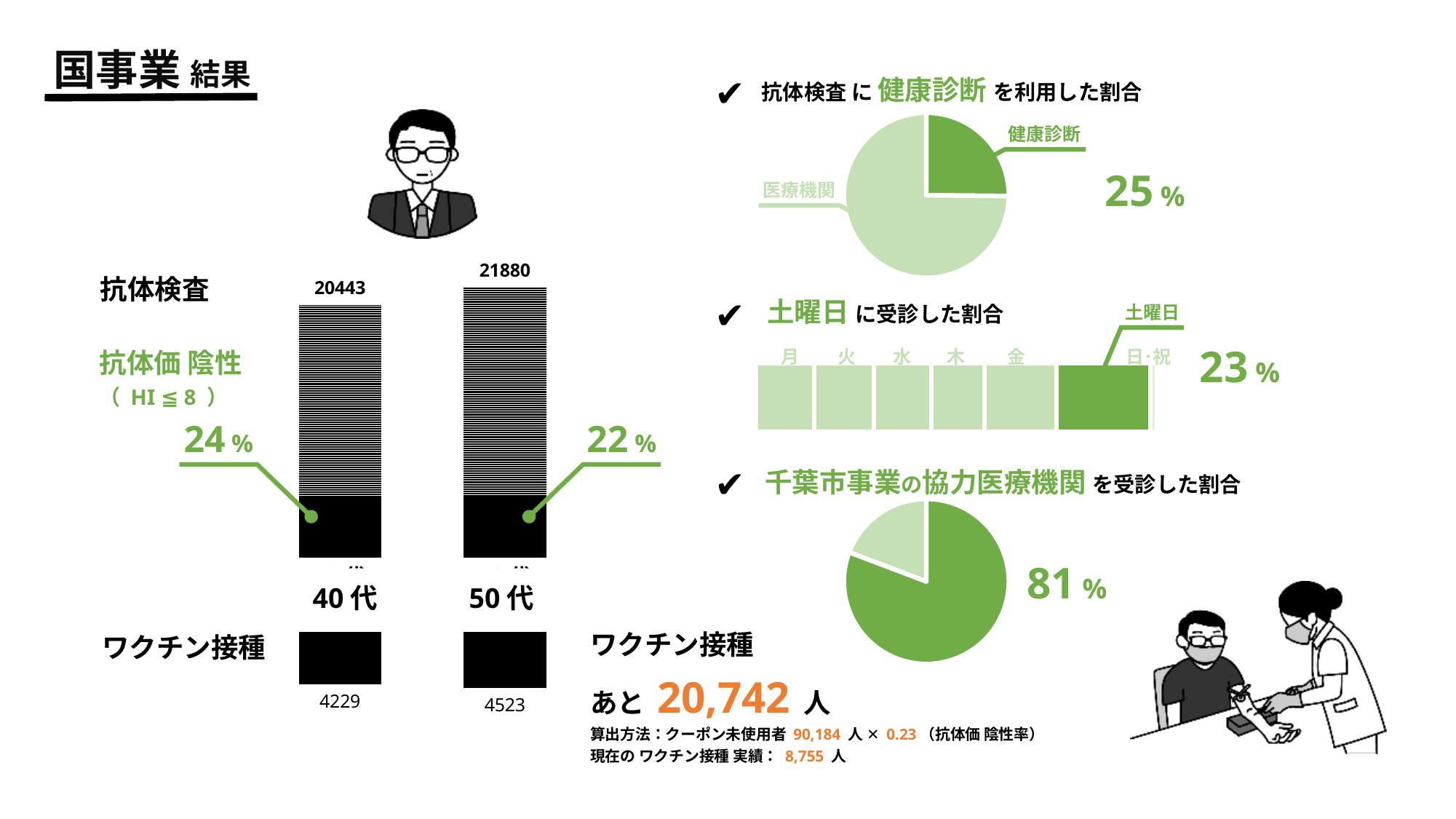
In the 抗体検査 bar chart on the left, what is the difference between the 50代 and 40代 values? 1437 In the bottom-right pie chart (千葉市事業の協力医療機関を受診した割合), what share is highlighted in dark green? 81% In the chart on the left, what percentage of 50代 is labelled 抗体価 陰性 (HI ≦ 8)? 22% In the 抗体検査 bar chart on the left, which age group has the higher value, 40代 or 50代? 50代 In the 抗体検査 bar chart on the left, what is the value for 40代? 20443 In the middle-right chart (土曜日に受診した割合), what percentage is shown for 土曜日? 23% In the ワクチン接種 bars on the left, what is the value for 50代? 4523 In the ワクチン接種 bars on the left, what is the value for 40代? 4229 In the top-right pie chart (抗体検査に健康診断を利用した割合), what share is 健康診断? 25% In the 抗体検査 bar chart on the left, what is the value for 50代? 21880 In the chart on the left, what percentage of 40代 is labelled 抗体価 陰性 (HI ≦ 8)? 24% In the ワクチン接種 bars on the left, what is the difference between the 50代 and 40代 values? 294